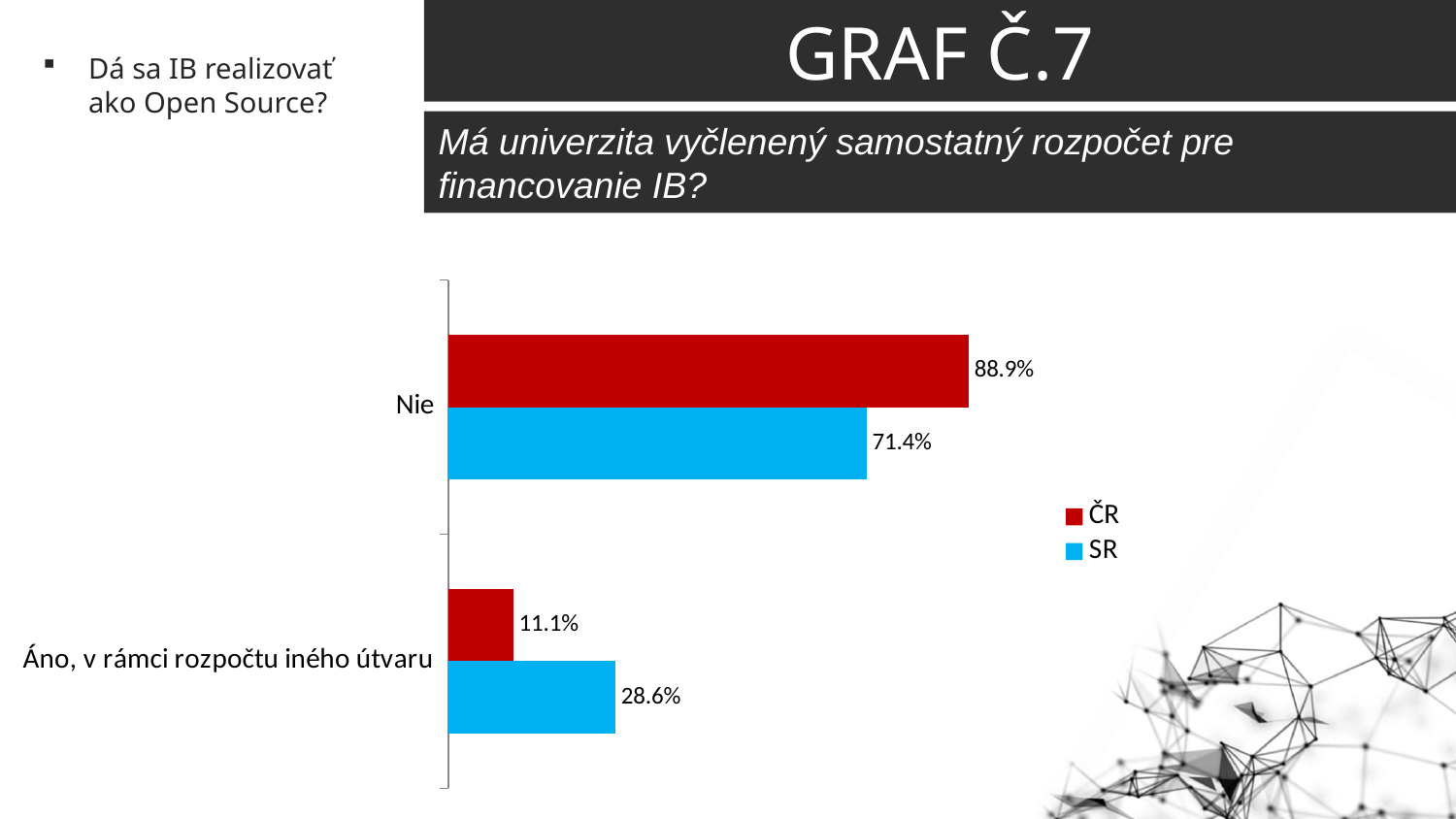
What is the value for ČR in the 'Nie' category? 88.9% What is the difference between the ČR and SR values in the 'Nie' category? 17.5% Which category has the highest value for ČR? Nie What is the value for ČR in the 'Áno, v rámci rozpočtu iného útvaru' category? 11.1% In the 'Áno, v rámci rozpočtu iného útvaru' category, which series has the larger value, ČR or SR? SR What kind of chart is shown on the slide? Bar chart What is the value for SR in the 'Nie' category? 71.4% How many series does the legend list? 2 Which colour represents the SR series in the legend? Blue Which category has the lowest value for SR? Áno, v rámci rozpočtu iného útvaru What is the value for SR in the 'Áno, v rámci rozpočtu iného útvaru' category? 28.6% How many categories are shown on the chart? 2